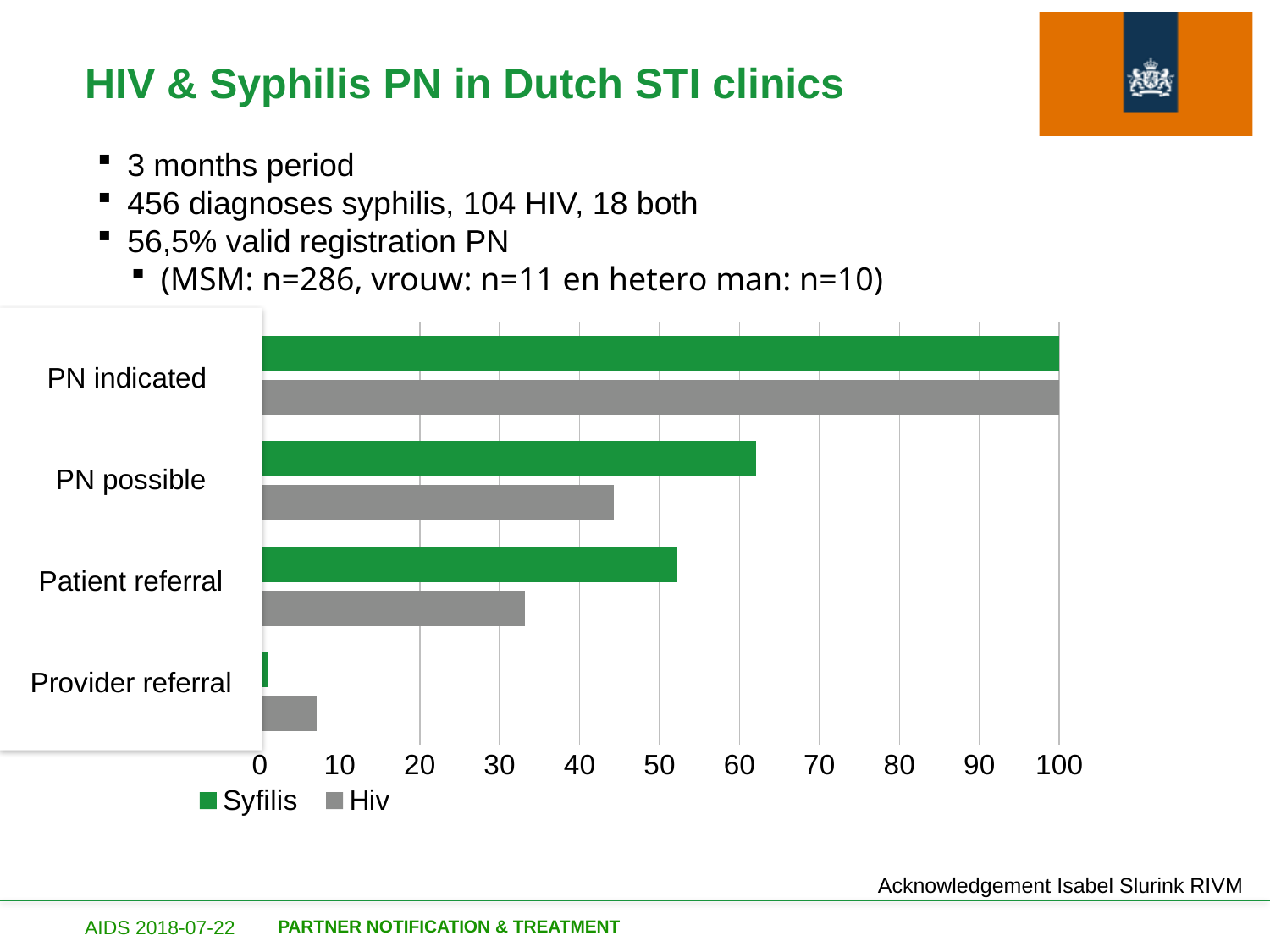
What kind of chart is shown on the slide? bar chart Which two series are listed in the chart legend? Syfilis and Hiv What is the value of the Hiv bar for PN indicated? 100 How many series does the chart legend list? 2 Is the Hiv value for Patient referral greater or less than 30? greater How many categories are shown on the chart's vertical axis? 4 What colour are the Syfilis bars in the chart? green Is the Syfilis value for PN possible greater or less than 60? greater Is the Hiv value for PN possible greater or less than 50? less What is the value of the Syfilis bar for PN indicated? 100 For Patient referral, which series has the larger value, Syfilis or Hiv? Syfilis Which category has the lowest Syfilis value? Provider referral